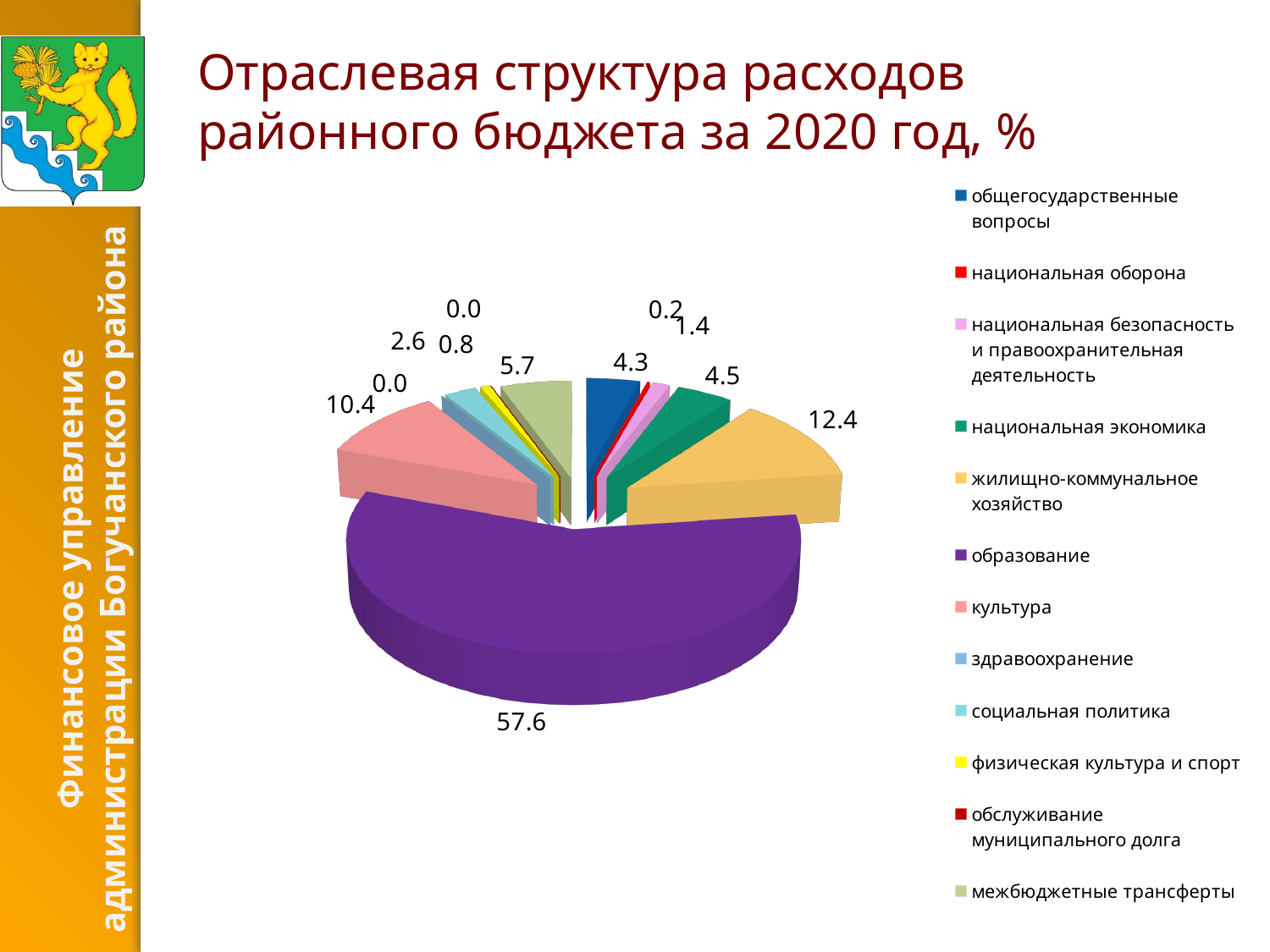
What kind of chart is shown on the slide? pie chart Which category has the largest share of the pie? образование What is the value for социальная политика? 2.6 What is the value for образование? 57.6 What is the value for межбюджетные трансферты? 5.7 What is the title of the chart on the slide? Отраслевая структура расходов районного бюджета за 2020 год, % What is the value for жилищно-коммунальное хозяйство? 12.4 How many categories does the legend list? 12 Which is larger, the value for общегосударственные вопросы or the value for национальная экономика? национальная экономика What is the difference between the values for жилищно-коммунальное хозяйство and культура? 2.0 What is the value for культура? 10.4 What is the value for национальная экономика? 4.5